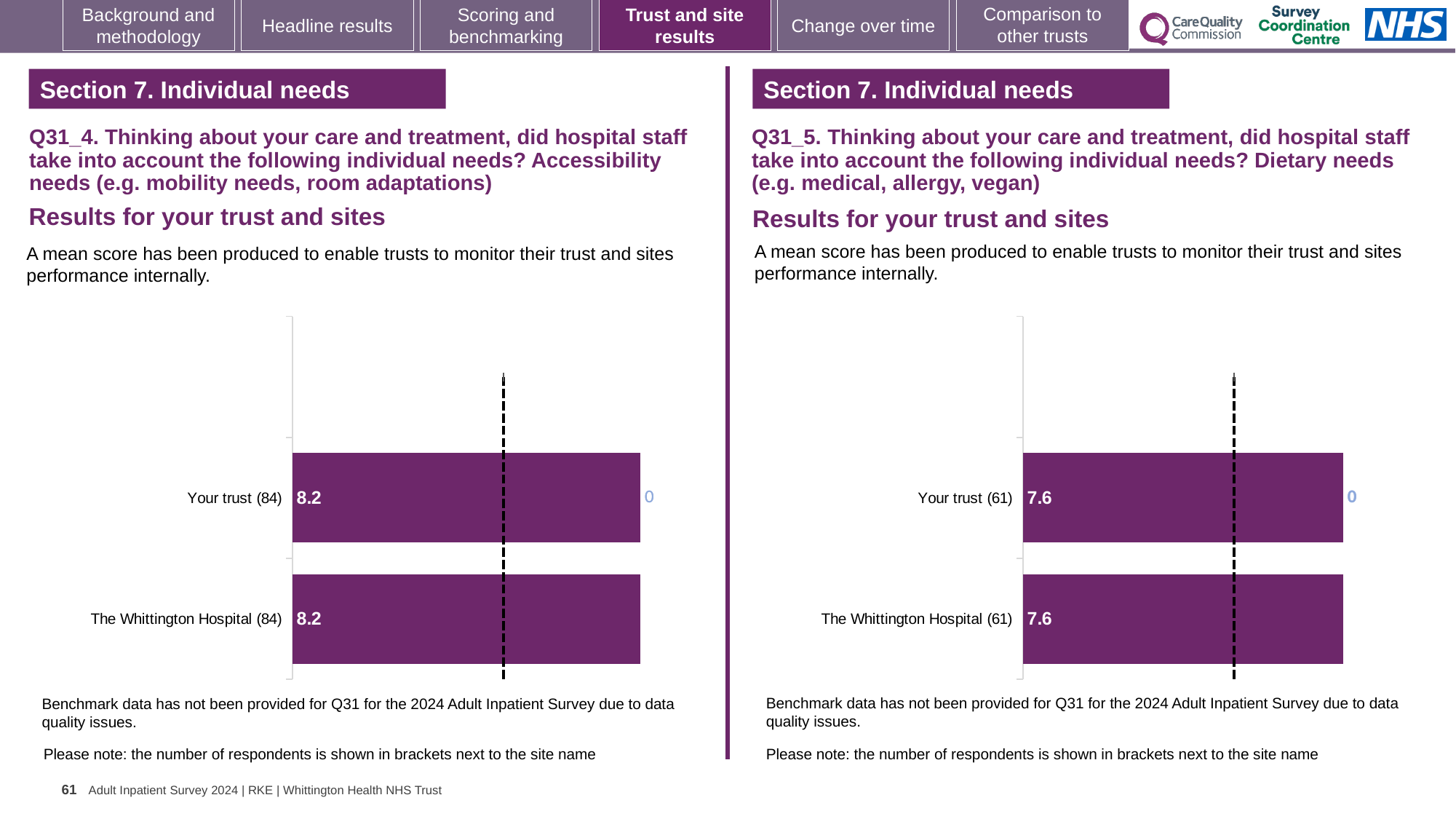
What is the difference between the Your trust score in the left chart (Q31_4) and the Your trust score in the right chart (Q31_5)? 0.6 In the left chart (Q31_4, Accessibility needs), what is the mean score for The Whittington Hospital? 8.2 In the right chart (Q31_5, Dietary needs), what is the mean score for Your trust? 7.6 How many bars are plotted in the right chart (Q31_5, Dietary needs)? 2 In the right chart (Q31_5, Dietary needs), how many respondents are shown in brackets next to The Whittington Hospital? 61 In the right chart (Q31_5, Dietary needs), what is the mean score for The Whittington Hospital? 7.6 What type of chart is used in the left chart (Q31_4, Accessibility needs)? Bar chart In the left chart (Q31_4, Accessibility needs), what is the mean score for Your trust? 8.2 How many bars are plotted in the left chart (Q31_4, Accessibility needs)? 2 Is the Your trust score in the left chart (Q31_4) larger or smaller than the Your trust score in the right chart (Q31_5)? Larger What type of chart is used in the right chart (Q31_5, Dietary needs)? Bar chart In the left chart (Q31_4, Accessibility needs), how many respondents are shown in brackets next to Your trust? 84